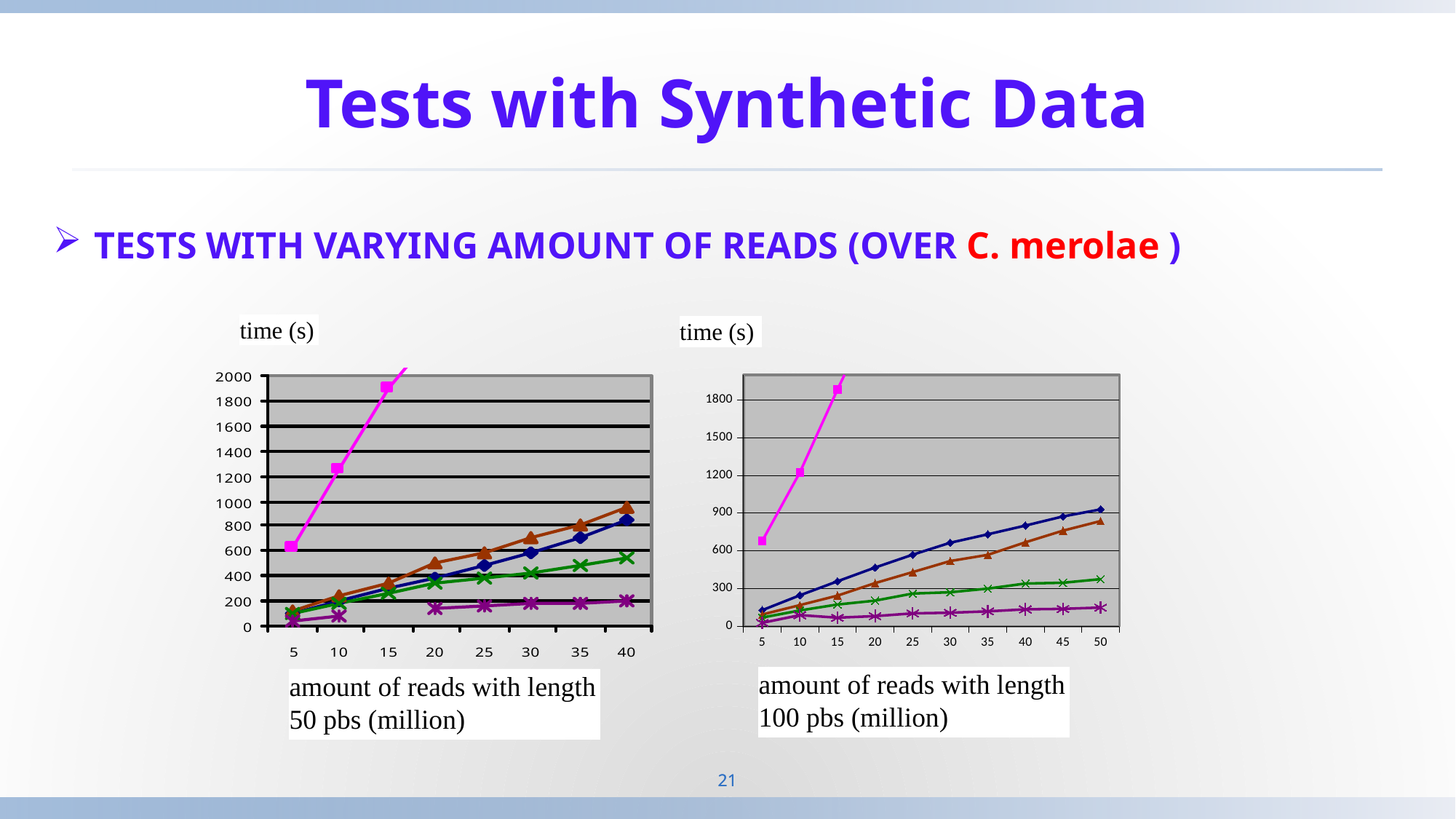
What is the label on the y axis of both charts? time (s) In the right chart (reads with length 100 pbs), at 50 million reads, which line is higher: the blue line or the orange line? the blue line In the left chart (reads with length 50 pbs), how many values are marked on the x axis? 8 In the right chart (reads with length 100 pbs), is the value of the magenta line at 15 greater or less than 1500? greater In the left chart (reads with length 50 pbs), which coloured line has the lowest time values? the purple line In the left chart (reads with length 50 pbs), is the value of the magenta line at 15 greater or less than 1800? greater In the left chart (reads with length 50 pbs), at 40 million reads, which line is higher: the orange line or the blue line? the orange line In the right chart (reads with length 100 pbs), how many values are marked on the x axis? 10 In the left chart (reads with length 50 pbs), is the value of the purple line at 40 greater or less than 400? less In the left chart (reads with length 50 pbs), which coloured line reaches the highest time values? the magenta line In the right chart (reads with length 100 pbs), does the blue line rise or fall as the amount of reads increases? rises What type of chart is the left chart on the slide? line chart